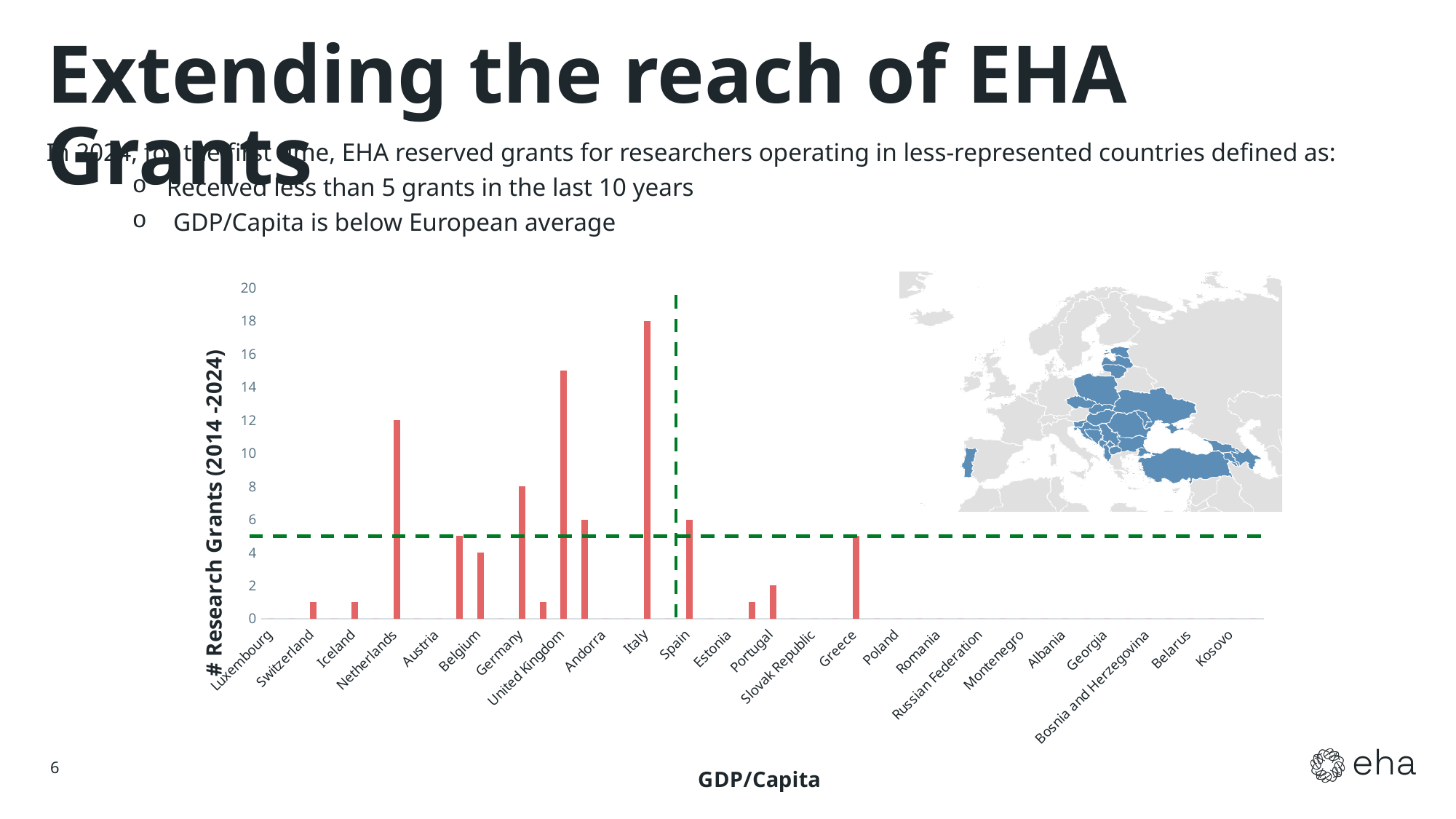
What is the difference in research grants between Italy and the Netherlands? 6 Which has more research grants, Italy or the United Kingdom? Italy Which country has the highest number of research grants in the chart? Italy How many research grants (2014-2024) does the Netherlands have according to the chart? 12 What kind of chart is shown on the slide? bar chart Is the value for Switzerland greater or less than 4? less Is the value for the Netherlands greater or less than 10? greater How many research grants (2014-2024) does Italy have according to the chart? 18 What is the title of the horizontal axis of the chart? GDP/Capita How many research grants (2014-2024) does Germany have according to the chart? 8 What is the title of the vertical axis of the chart? # Research Grants (2014 -2024) Is the value for Greece greater or less than 10? less